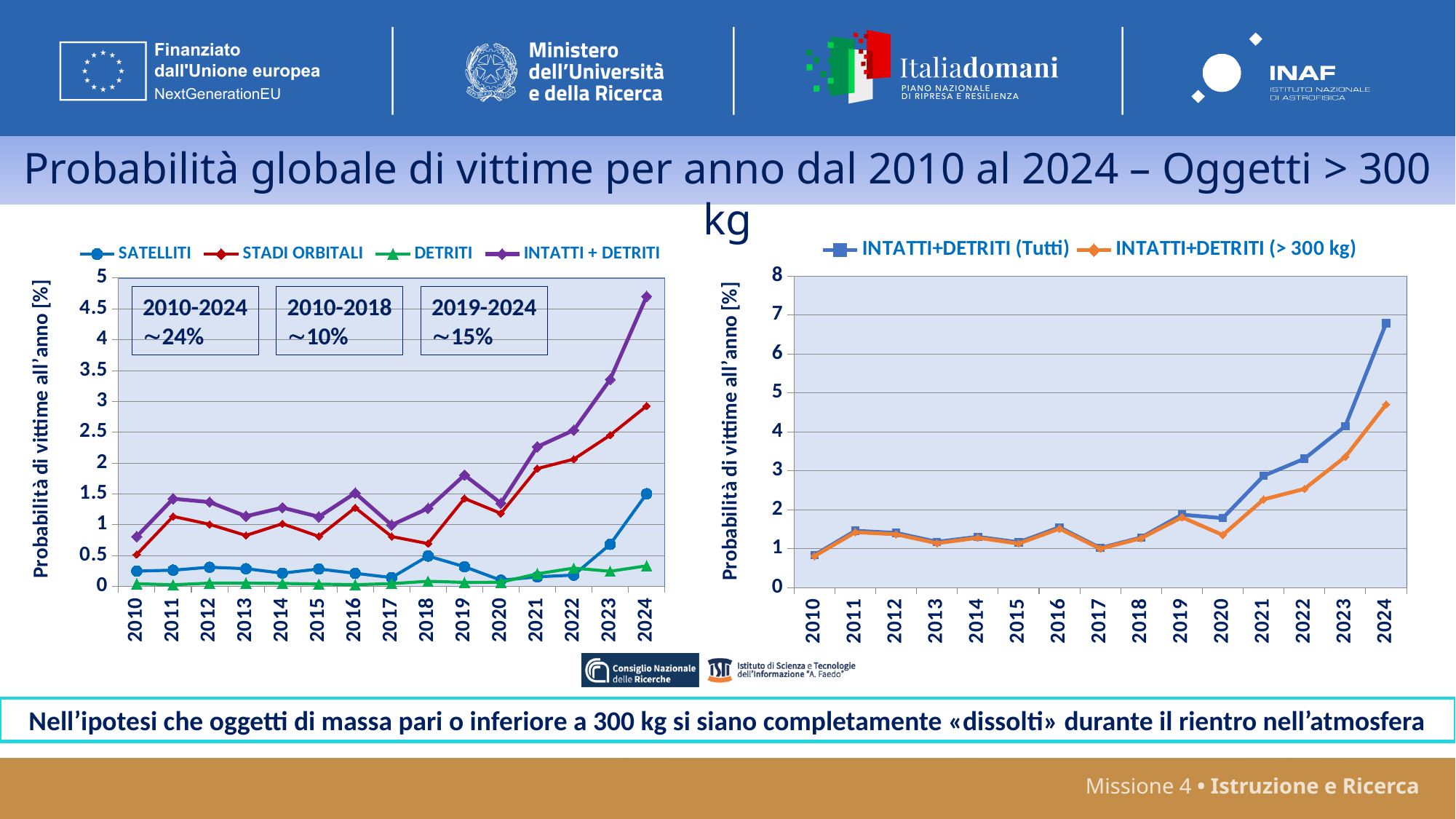
In the left chart, is the value of STADI ORBITALI in 2024 greater or less than 2.5? greater In the left chart, which series has the lowest value in 2024? DETRITI In the left chart, which series has the highest value in 2024? INTATTI + DETRITI In the right chart, does the INTATTI+DETRITI (Tutti) series overall rise or fall from 2010 to 2024? rise How many series does the legend of the left chart list? 4 In the right chart, which series is higher in 2024, INTATTI+DETRITI (Tutti) or INTATTI+DETRITI (> 300 kg)? INTATTI+DETRITI (Tutti) What kind of chart is the left chart on the slide? line chart How many years are plotted along the x axis of the right chart? 15 In the right chart, is the value of INTATTI+DETRITI (Tutti) in 2024 greater or less than 6? greater In the left chart, is the value of INTATTI + DETRITI in 2024 greater or less than 4? greater What is the y-axis label of the right chart? Probabilità di vittime all'anno [%] How many series does the legend of the right chart list? 2